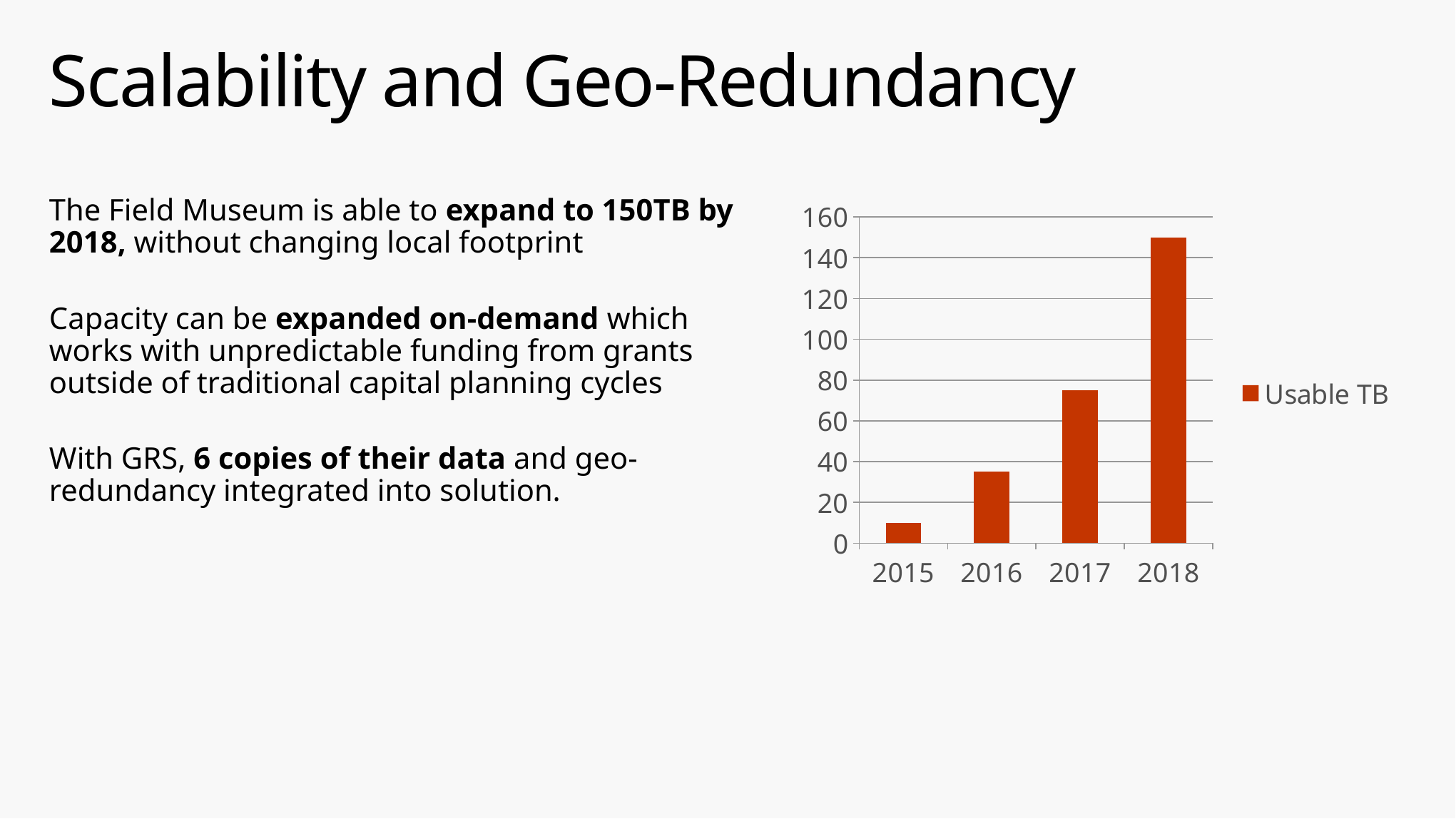
Do the Usable TB values rise or fall from 2015 to 2018? rise Is the Usable TB value for 2018 greater or less than 140? greater Which year has the highest Usable TB value? 2018 Which year has the lowest Usable TB value? 2015 Is the Usable TB value for 2015 greater or less than 20? less Which year has a larger Usable TB value, 2016 or 2017? 2017 How many years are shown on the x axis of the chart? 4 What kind of chart is shown on the slide? bar chart Is the Usable TB value for 2017 greater or less than 60? greater What is the name of the series shown in the chart legend? Usable TB How many series does the chart legend list? 1